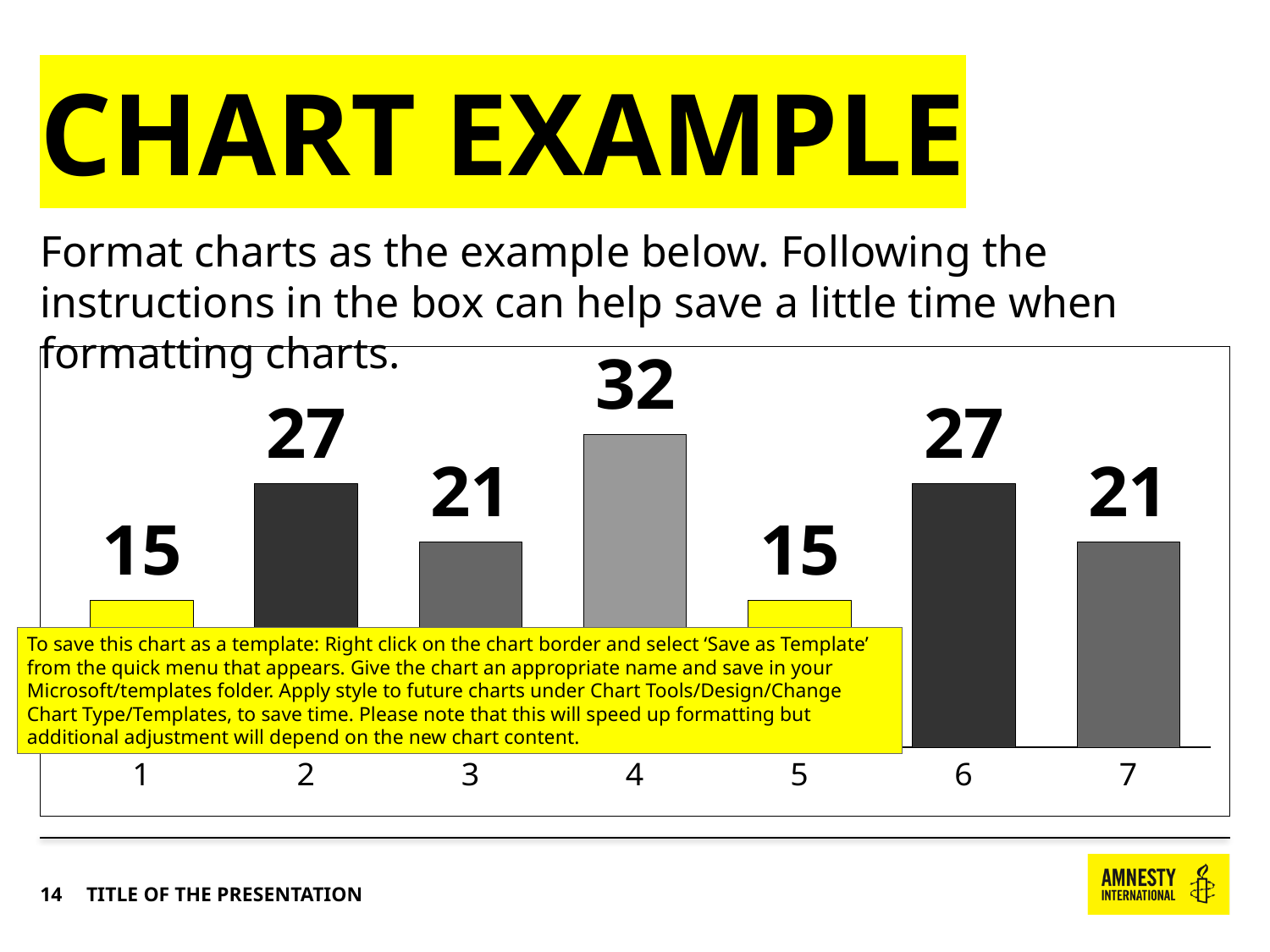
What colour are the bars for categories 1 and 5? yellow What is the value for category 7? 21 Which category has the highest value? 4 Which is larger, the value for category 6 or the value for category 7? category 6 What is the difference between the values for category 2 and category 1? 12 What is the difference between the values for category 4 and category 3? 11 Which categories share the lowest value of 15? 1 and 5 What is the value for category 4? 32 How many categories are shown on the x axis? 7 What kind of chart is shown on the slide? bar chart What is the value for category 1? 15